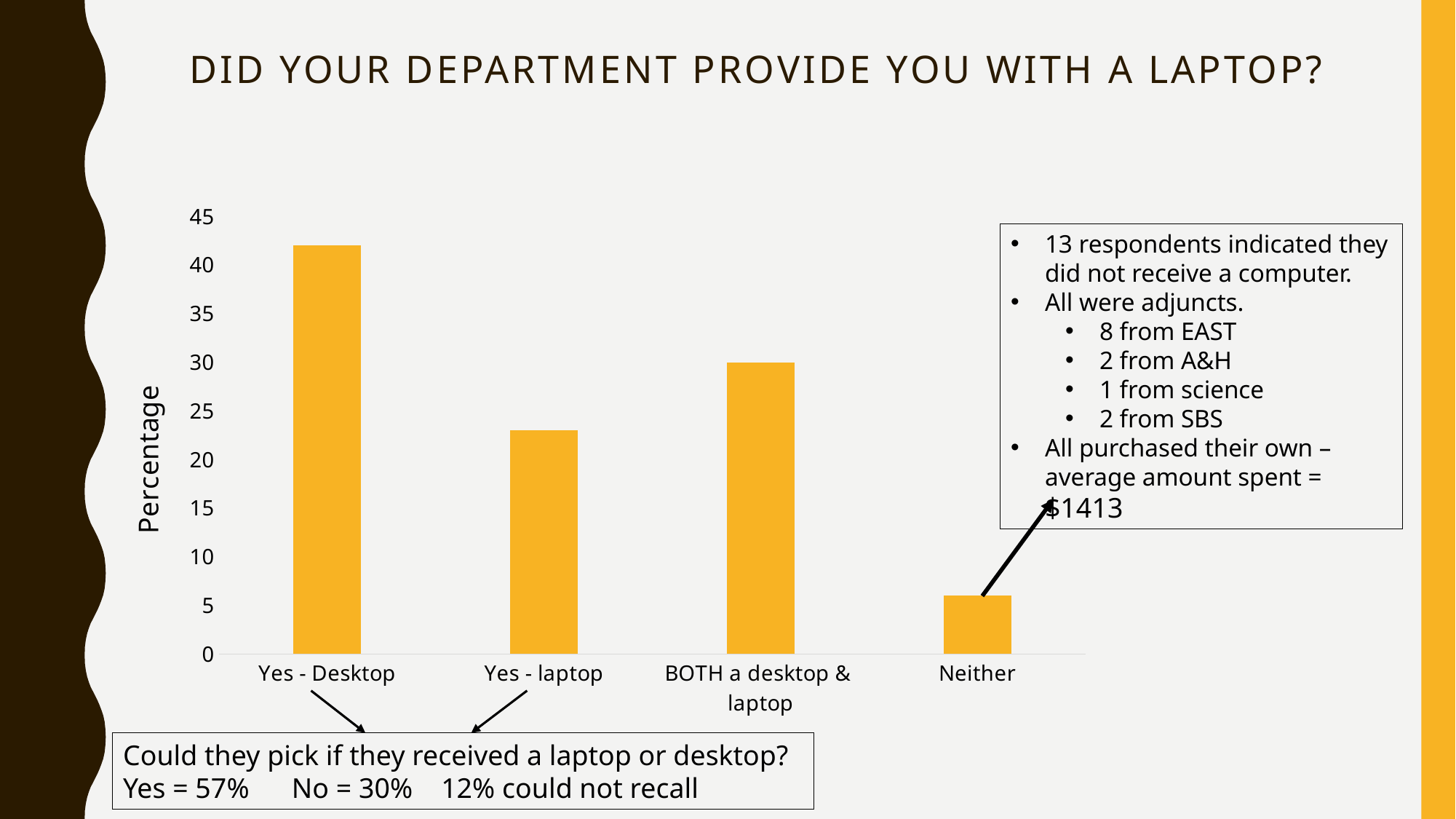
What is the title of the slide containing the chart? DID YOUR DEPARTMENT PROVIDE YOU WITH A LAPTOP? Is the value for Neither greater or less than 10? less What is the label on the vertical axis of the chart? Percentage Which category has the lowest bar in the chart? Neither What kind of chart is shown on the slide? Bar chart Which category has the highest bar in the chart? Yes - Desktop Is the value for Yes - laptop greater or less than 20? greater Is the value for Yes - Desktop greater or less than 40? greater How many categories are shown on the x axis of the chart? 4 Which is larger, the value for BOTH a desktop & laptop or the value for Yes - laptop? BOTH a desktop & laptop What is the percentage for BOTH a desktop & laptop? 30